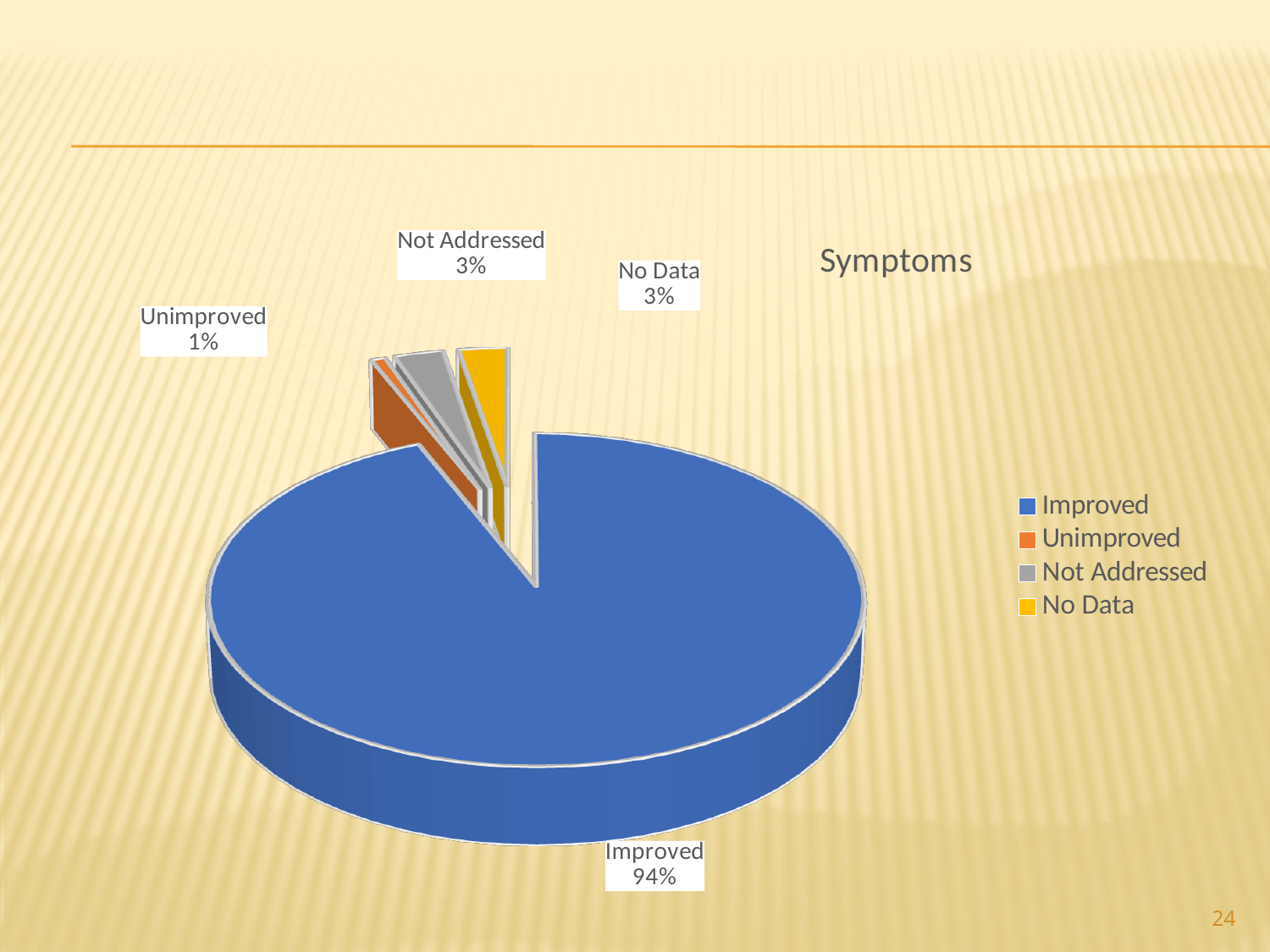
What is the value shown for Not Addressed? 3% What is the difference between the Not Addressed and Unimproved percentages? 2% Which category has the smallest slice of the pie? Unimproved What is the value shown for No Data? 3% How many categories are shown in the pie chart? 4 Which category has the largest slice of the pie? Improved Which is larger, the Not Addressed slice or the Unimproved slice? Not Addressed What kind of chart is shown on the slide? Pie chart What is the difference between the Improved and Unimproved percentages? 93% What is the title of the chart? Symptoms What share of the pie does Improved represent? 94% What is the value shown for Unimproved? 1%